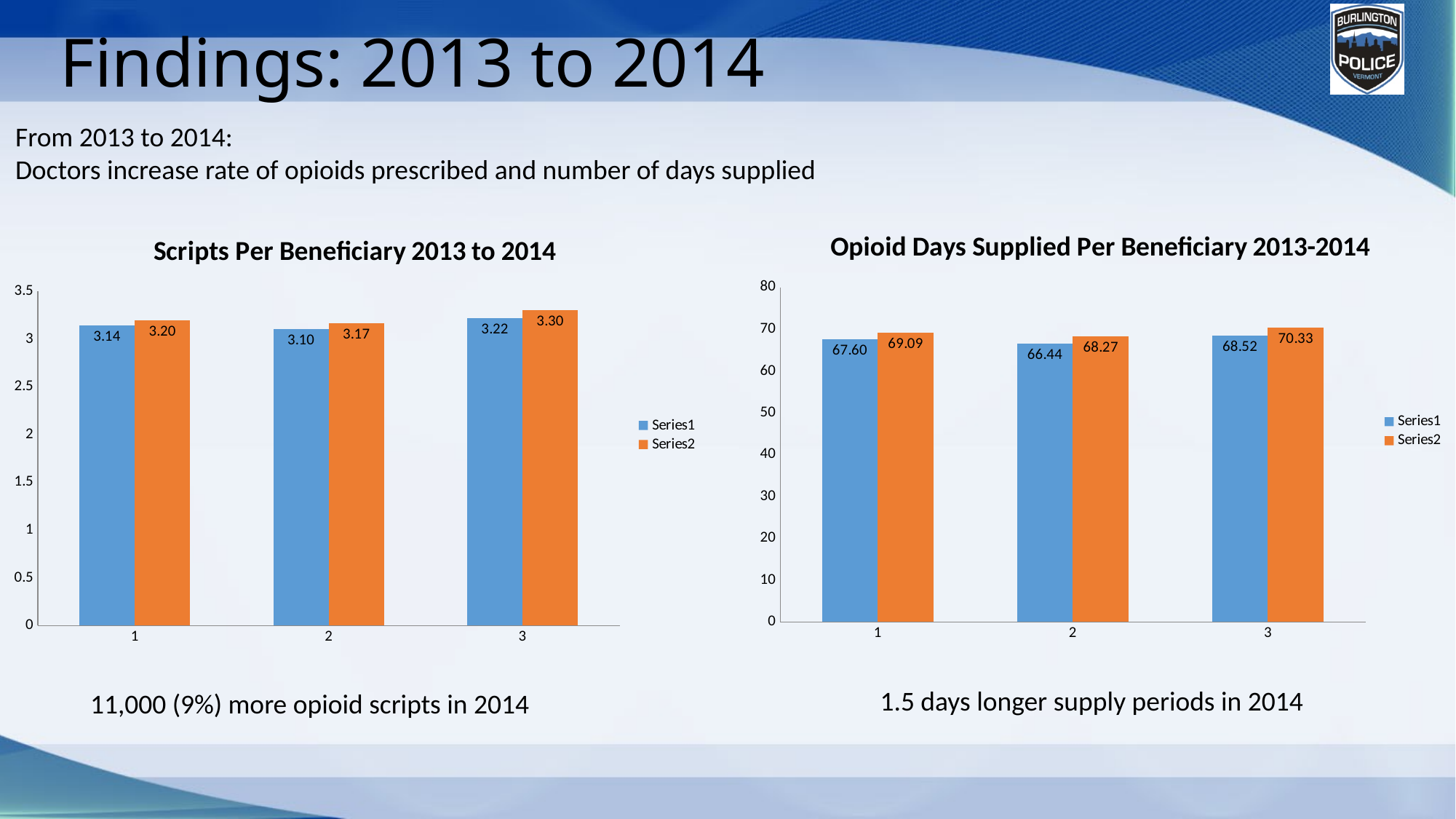
In the 'Opioid Days Supplied Per Beneficiary 2013-2014' chart, which is larger for category 1: Series1 or Series2? Series2 In the 'Opioid Days Supplied Per Beneficiary 2013-2014' chart, what is the Series1 value for category 2? 66.44 How many categories are shown on the x axis of the 'Scripts Per Beneficiary 2013 to 2014' chart? 3 In the 'Opioid Days Supplied Per Beneficiary 2013-2014' chart, which category has the highest Series2 value? 3 In the 'Scripts Per Beneficiary 2013 to 2014' chart, which category has the lowest Series1 value? 2 In the 'Scripts Per Beneficiary 2013 to 2014' chart, what is the difference between the Series2 and Series1 values for category 2? 0.07 How many series does the legend of the 'Opioid Days Supplied Per Beneficiary 2013-2014' chart list? 2 In the 'Scripts Per Beneficiary 2013 to 2014' chart, what is the Series1 value for category 1? 3.14 In the 'Opioid Days Supplied Per Beneficiary 2013-2014' chart, what is the difference between the Series2 and Series1 values for category 3? 1.81 What kind of chart is the 'Scripts Per Beneficiary 2013 to 2014' chart? Bar chart In the 'Scripts Per Beneficiary 2013 to 2014' chart, what is the Series2 value for category 3? 3.30 In the 'Opioid Days Supplied Per Beneficiary 2013-2014' chart, what is the Series2 value for category 1? 69.09